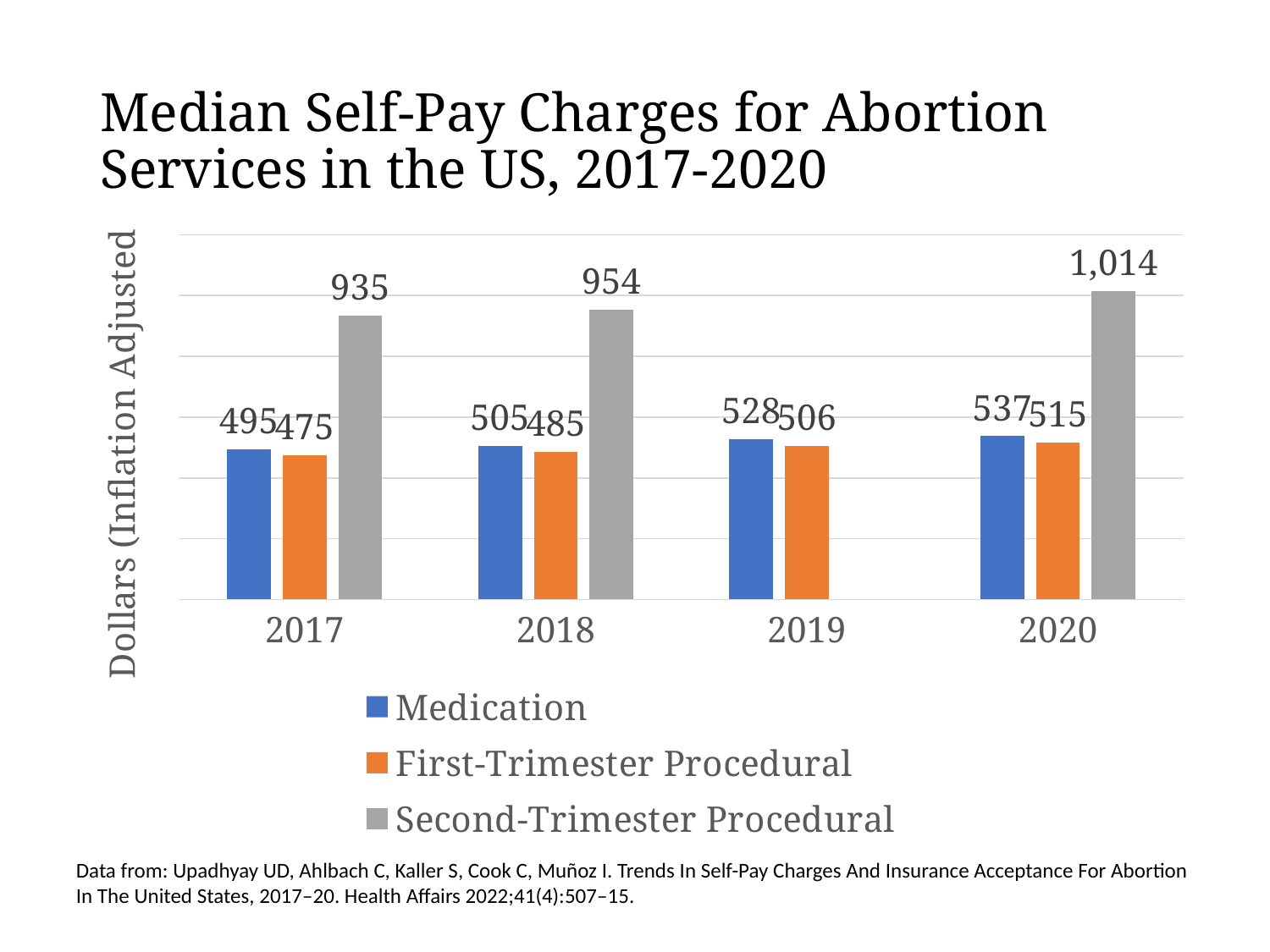
What is the value for First-Trimester Procedural in 2017? 475 What is the difference between the Medication and First-Trimester Procedural charges in 2018? 20 What is the difference between the Second-Trimester Procedural charge in 2020 and in 2017? 79 How many years are shown on the x axis? 4 Which is larger in 2020, the Medication charge or the First-Trimester Procedural charge? Medication What is the value for Second-Trimester Procedural in 2020? 1,014 What is the median self-pay charge for Medication in 2019? 528 Does the Medication charge rise or fall from 2017 to 2020? Rise In which year is the Medication charge highest? 2020 In which year is the First-Trimester Procedural charge lowest? 2017 What kind of chart is shown on the slide? Bar chart How many series does the legend list? 3